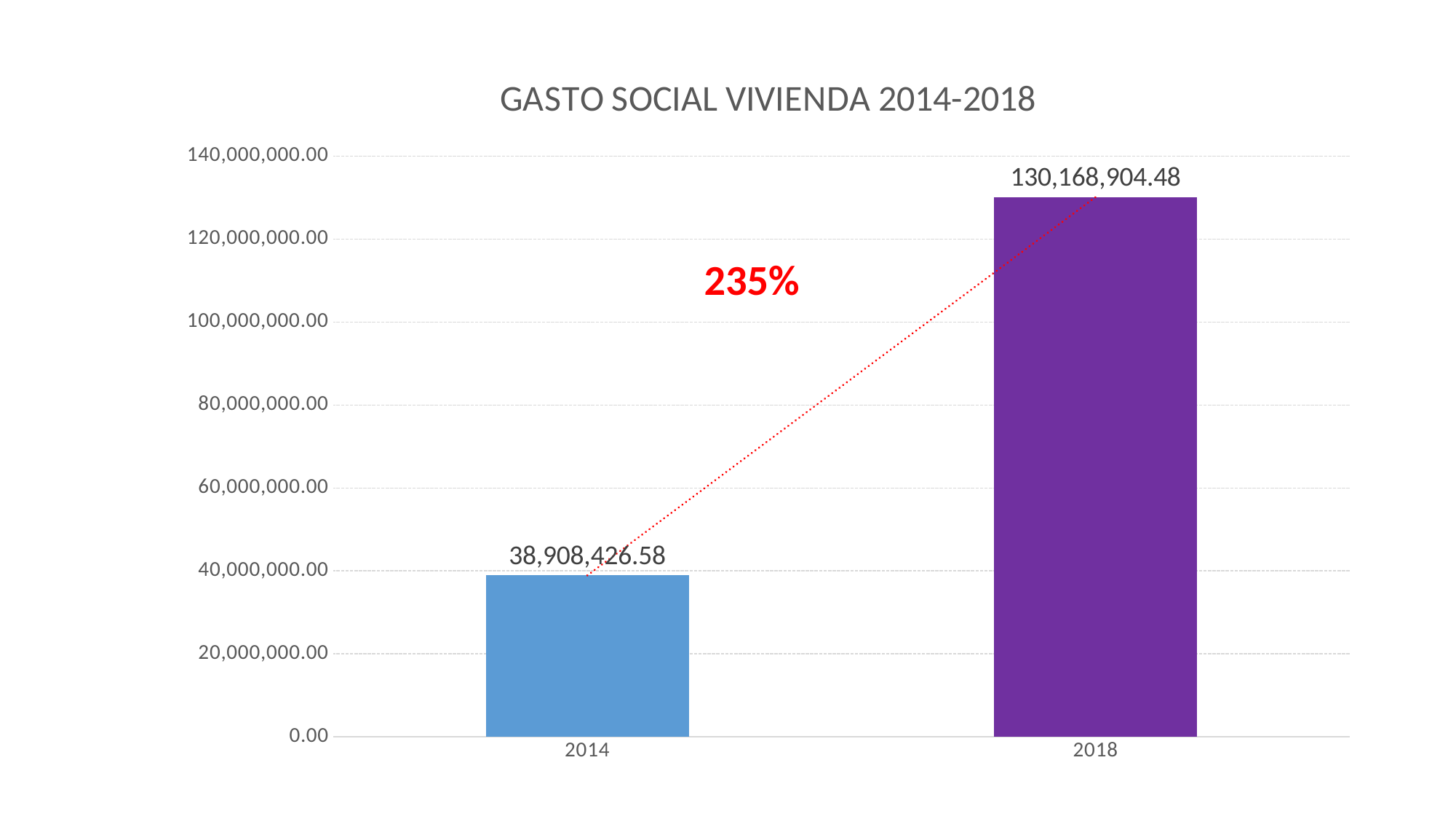
What is the title of the chart? GASTO SOCIAL VIVIENDA 2014-2018 Is the value for 2018 greater or less than 120,000,000.00? greater What is the difference between the values for 2018 and 2014? 91,260,477.90 How many years are shown on the x axis? 2 What is the value for 2018? 130,168,904.48 What kind of chart is shown on the slide? bar chart Which year has the highest value? 2018 Which is larger, the value for 2014 or the value for 2018? 2018 Is the value for 2014 greater or less than 40,000,000.00? less What is the value for 2014? 38,908,426.58 Do the values rise or fall from 2014 to 2018? rise Which year has the lowest value? 2014